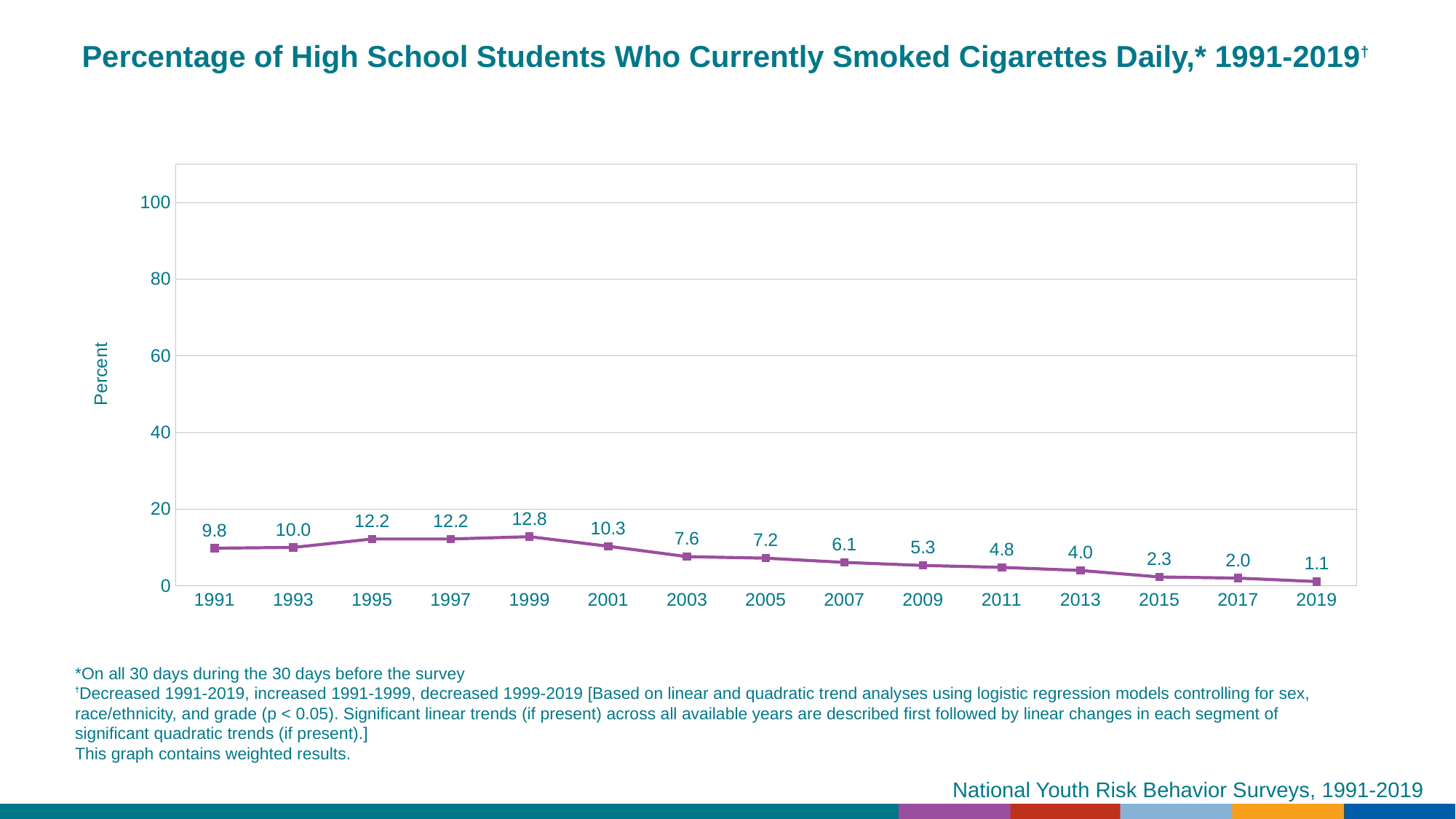
What kind of chart is shown on the slide? line chart How many years are plotted on the x axis? 15 What is the difference between the 1999 value and the 2019 value? 11.7 In which year was the percentage lowest? 2019 What is the overall trend of the values from 1999 to 2019? falling Which year has the larger value, 1993 or 2011? 1993 In which year was the percentage highest? 1999 What is the value shown for 2019? 1.1 What percentage of high school students currently smoked cigarettes daily in 1991? 9.8 What is the value shown for 2007? 6.1 Is the value for 1999 greater or less than 20? less What is the difference between the 2001 value and the 2003 value? 2.7